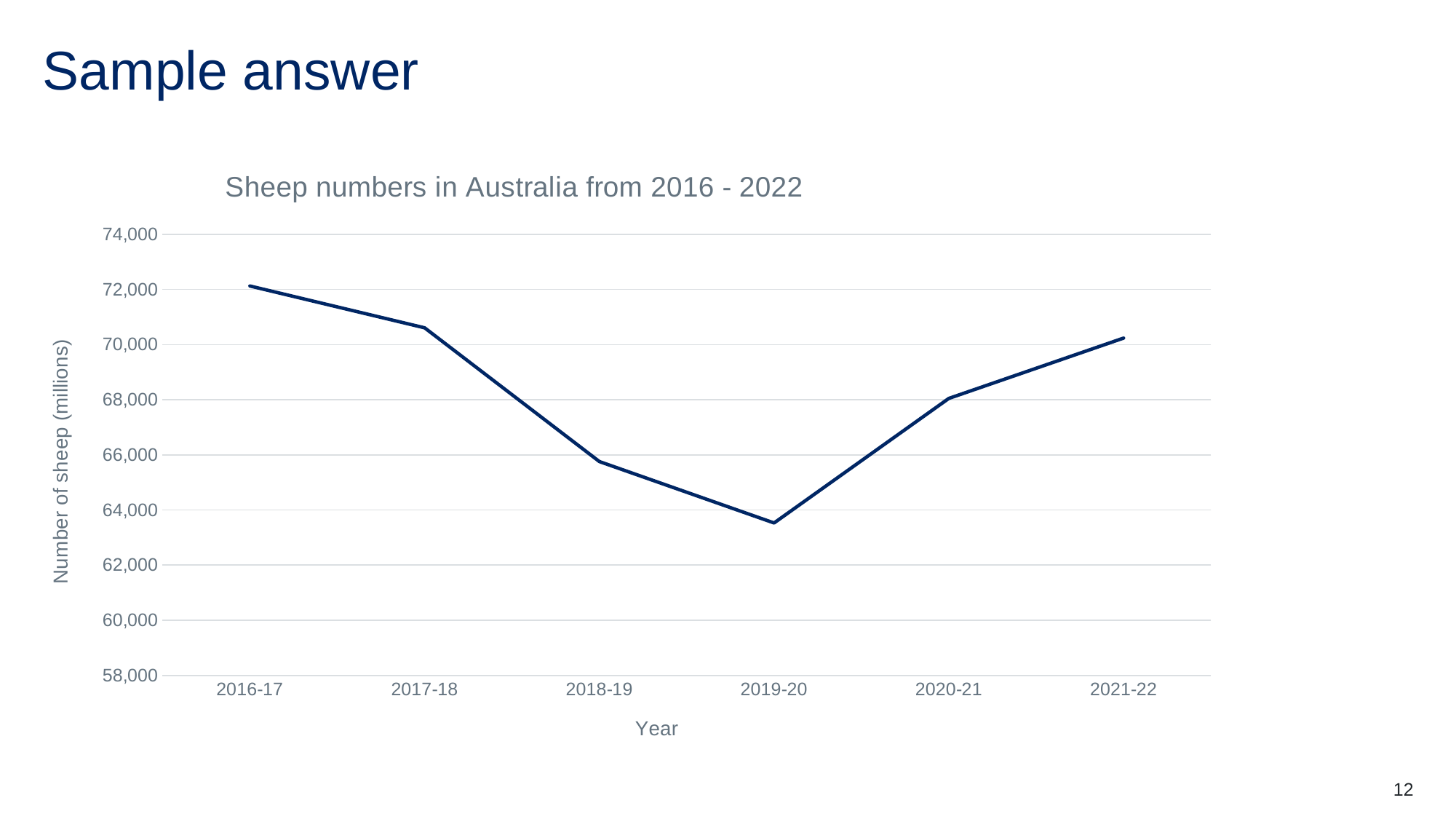
What is the title of the chart? Sheep numbers in Australia from 2016 - 2022 Is the value for 2019-20 greater or less than 64,000? less Which year has a higher number of sheep, 2017-18 or 2018-19? 2017-18 How do sheep numbers change from 2016-17 to 2019-20? They fall Which year has the highest number of sheep? 2016-17 What kind of chart is shown on the slide? Line chart What is the label on the vertical axis of the chart? Number of sheep (millions) Is the value for 2017-18 greater or less than 70,000? greater Is the value for 2021-22 greater or less than 68,000? greater Which year has the lowest number of sheep? 2019-20 How many years are plotted on the x axis of the chart? 6